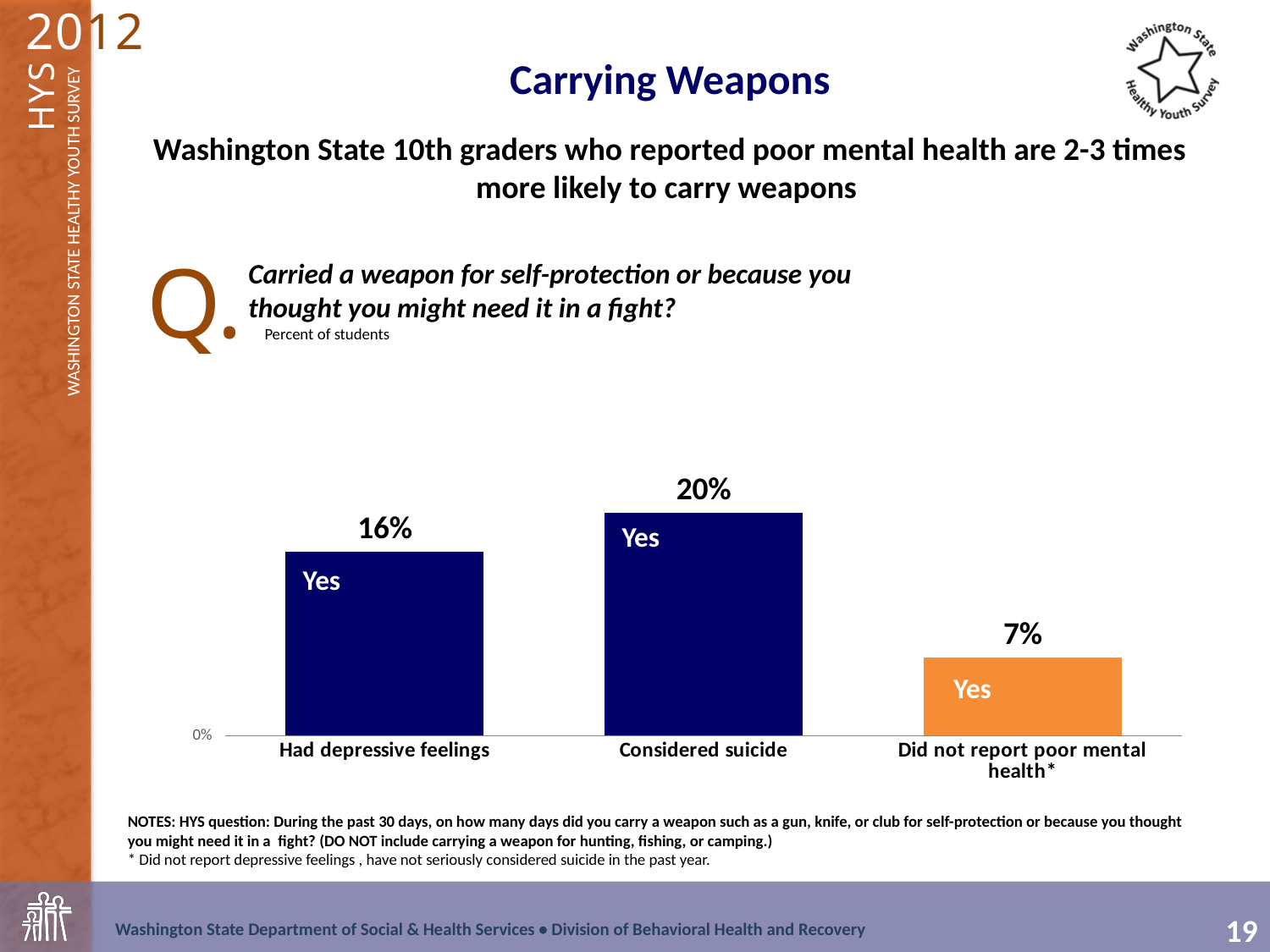
What is the difference in percentage points between students who considered suicide and students who had depressive feelings? 4 What label appears inside each bar on the chart? Yes What is the difference in percentage points between students who considered suicide and students who did not report poor mental health? 13 What percentage of students who did not report poor mental health reported carrying a weapon? 7% Which category has the highest percentage of students carrying a weapon? Considered suicide Which is larger: the value for 'Had depressive feelings' or the value for 'Did not report poor mental health*'? Had depressive feelings Which category has the lowest percentage of students carrying a weapon? Did not report poor mental health* What percentage of students who had depressive feelings reported carrying a weapon? 16% Which bar is coloured orange rather than dark blue? Did not report poor mental health* What type of chart is shown on the slide? Bar chart What percentage of students who considered suicide reported carrying a weapon? 20% How many categories are shown on the chart? 3